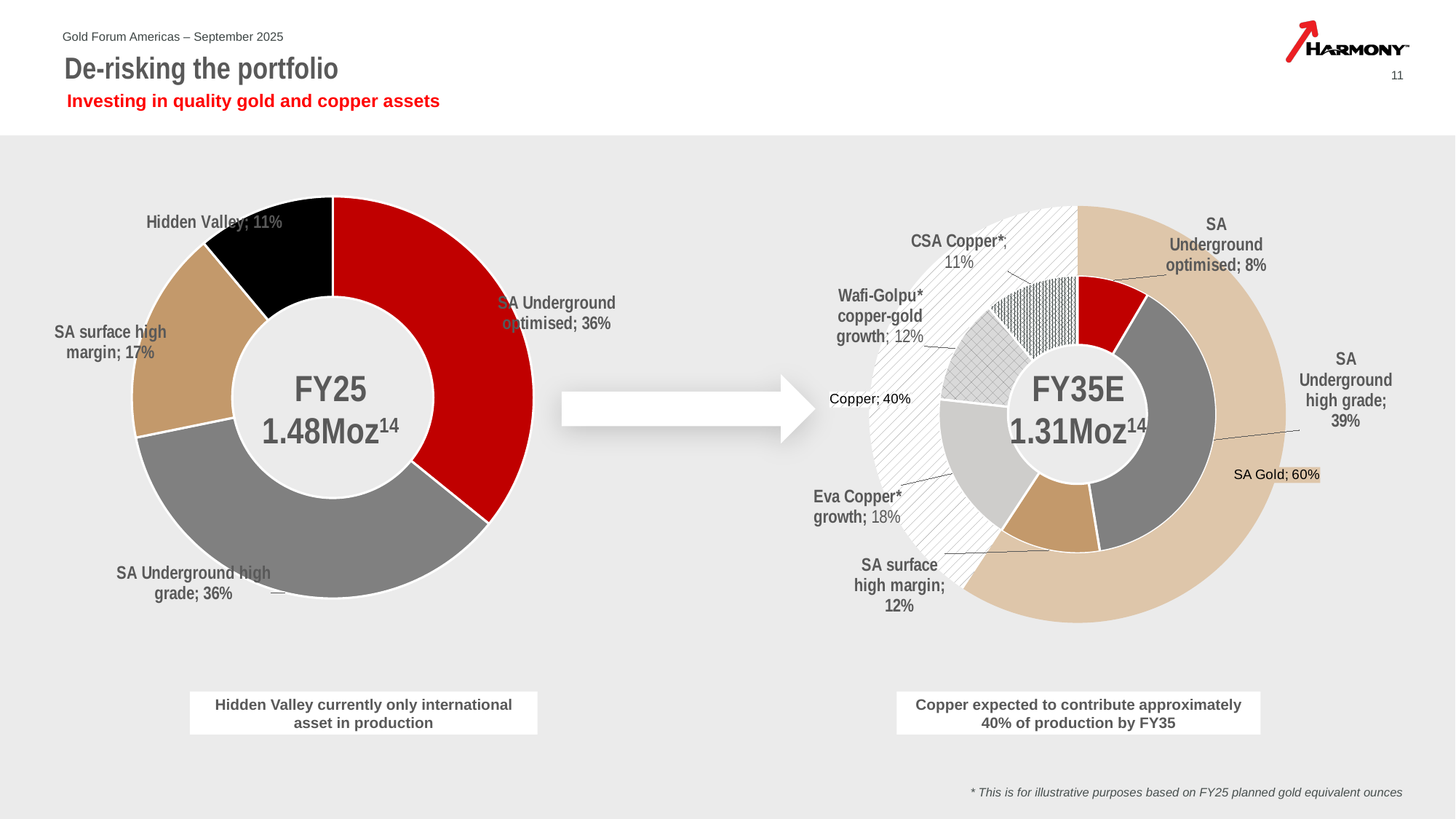
In the FY35E chart on the right, which category in the inner ring has the largest share? SA Underground high grade In the FY35E chart on the right, what share of production does Copper represent in the outer ring? 40% In the FY35E chart on the right, which category in the inner ring has the smallest share? SA Underground optimised In the FY35E chart on the right, which is larger: the Wafi-Golpu copper-gold growth share or the CSA Copper share? Wafi-Golpu copper-gold growth What total production figure is shown in the centre of the FY35E chart on the right? 1.31Moz In the FY25 chart on the left, what share does SA surface high margin contribute? 17% In the FY25 chart on the left, how many categories are shown? 4 In the FY25 chart on the left, which category has the smallest share? Hidden Valley In the FY35E chart on the right, what share does Eva Copper growth contribute? 18% In the FY25 chart on the left, what share does Hidden Valley contribute? 11% What kind of chart is the FY25 chart on the left? Doughnut (pie) chart In the FY25 chart on the left, what is the difference between the SA Underground high grade share and the SA surface high margin share? 19 percentage points